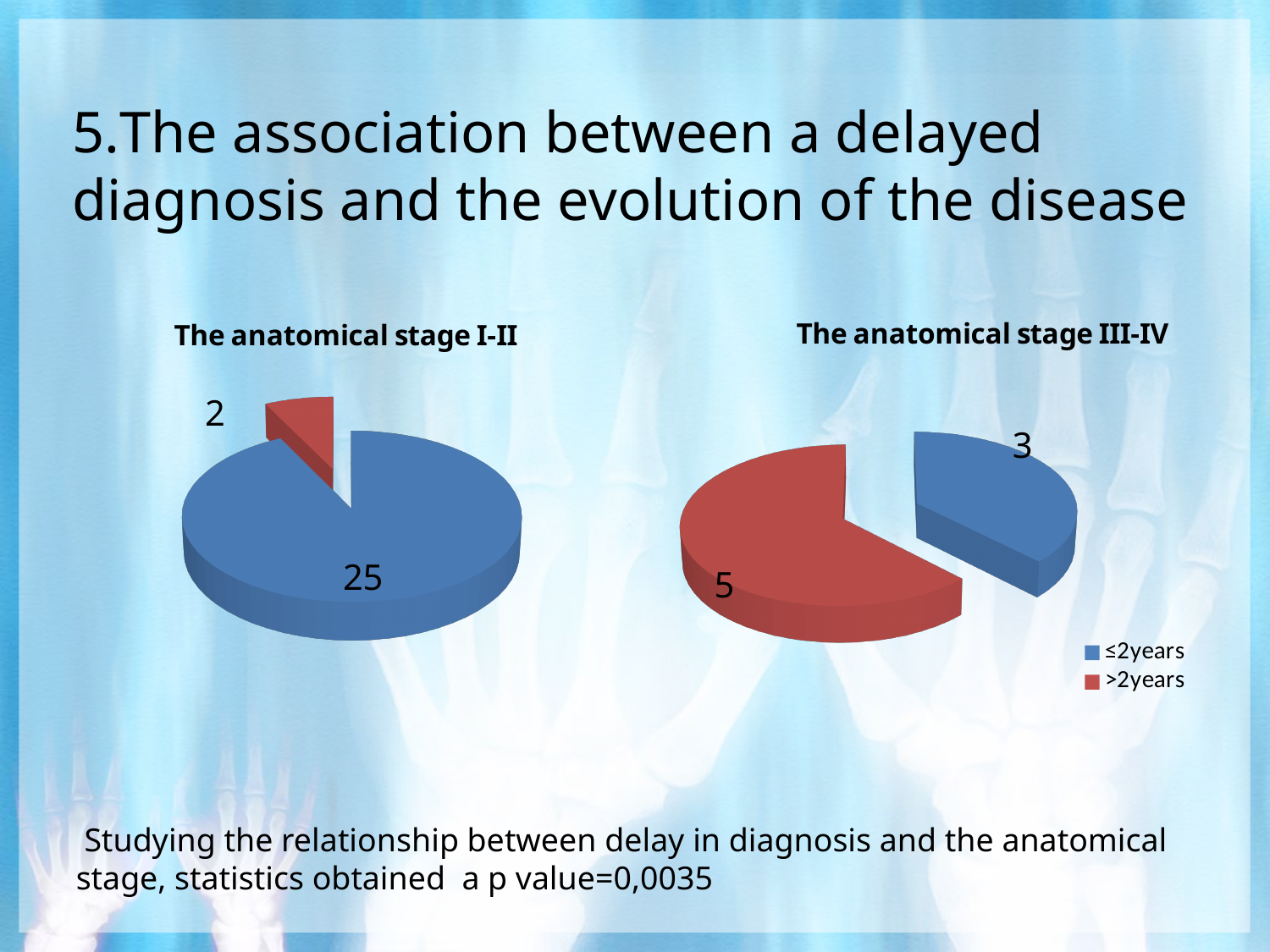
In the chart titled "The anatomical stage III-IV", what share of the total does the >2years slice represent? 62.5% In the chart titled "The anatomical stage III-IV", what is the value for >2years? 5 In the chart titled "The anatomical stage I-II", which category has the largest slice? ≤2years In the chart titled "The anatomical stage I-II", what is the difference between the ≤2years and >2years values? 23 What type of chart is the chart titled "The anatomical stage I-II"? Pie chart In the chart titled "The anatomical stage I-II", what is the value for ≤2years? 25 How many slices does the chart titled "The anatomical stage III-IV" have? 2 In the chart titled "The anatomical stage III-IV", which is larger, ≤2years or >2years? >2years How many entries does the legend on the slide list? 2 In the chart titled "The anatomical stage I-II", what is the value for >2years? 2 In the chart titled "The anatomical stage III-IV", which category has the smallest slice? ≤2years In the chart titled "The anatomical stage III-IV", what is the value for ≤2years? 3